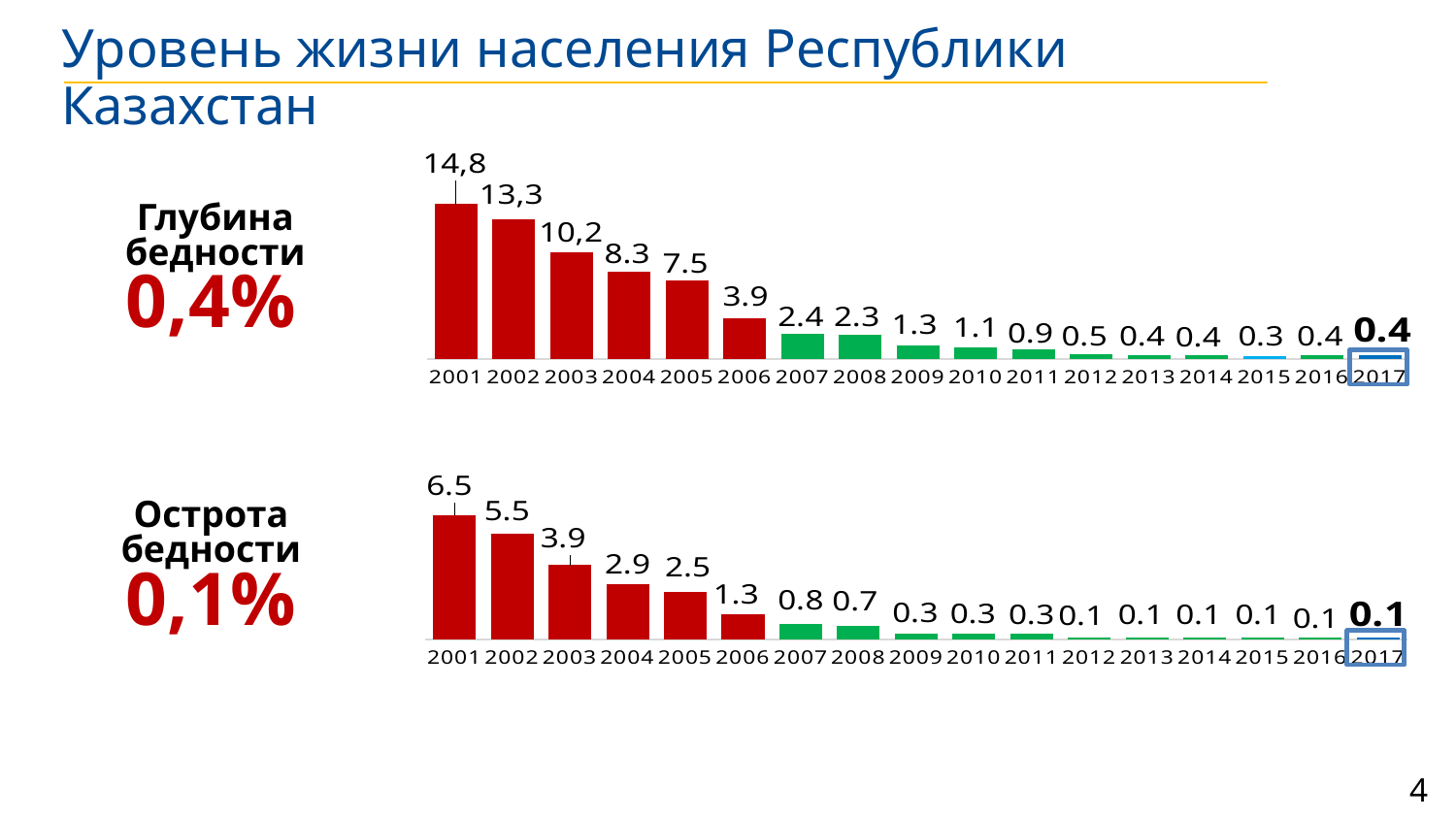
In the top chart (Глубина бедности), what is the difference between the values for 2001 and 2002? 1,5 In the top chart (Глубина бедности), what is the value for 2006? 3.9 In the top chart (Глубина бедности), what is the value for 2001? 14,8 In the bottom chart (Острота бедности), which year has the highest value? 2001 In the top chart (Глубина бедности), which is larger, the value for 2004 or the value for 2005? 2004 In the top chart (Глубина бедности), which year has the highest value? 2001 In the bottom chart (Острота бедности), what is the value for 2003? 3.9 In the bottom chart (Острота бедности), what is the difference between the values for 2001 and 2006? 5.2 How many years are shown on the x axis of the bottom chart (Острота бедности)? 17 What kind of chart is the top chart (Глубина бедности)? bar chart In the bottom chart (Острота бедности), do the values generally rise or fall from 2001 to 2017? fall In the bottom chart (Острота бедности), what is the value for 2017? 0.1